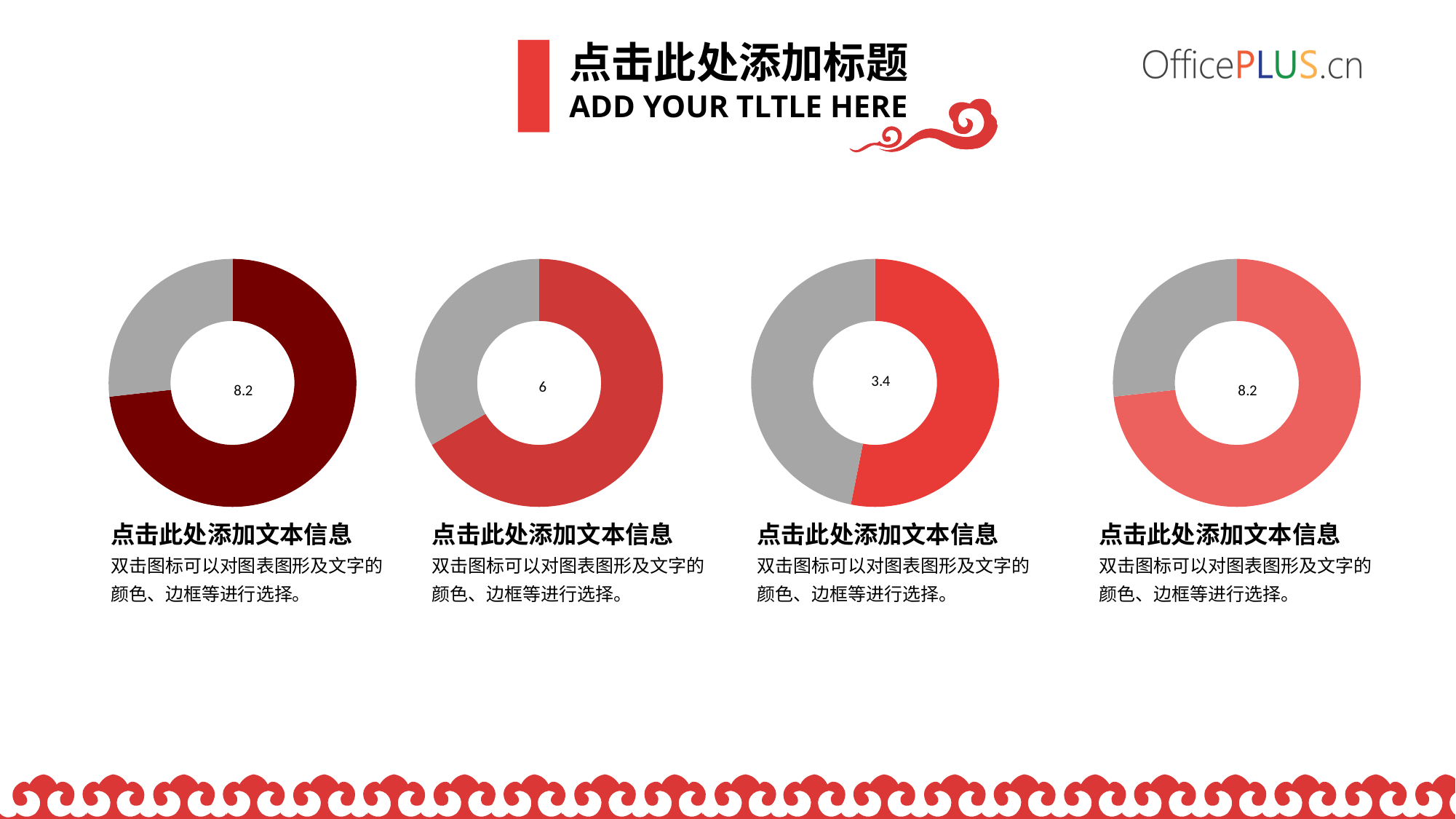
How many doughnut charts are shown on the slide? 4 What value is printed in the centre of the rightmost doughnut chart? 8.2 What kind of chart is the leftmost chart on the slide? Doughnut chart What is the difference between the centre value of the second chart (6) and the third chart (3.4)? 2.6 How many slices does each doughnut chart contain? 2 In the leftmost doughnut chart, which slice is larger, the dark red slice or the grey slice? The dark red slice What value is printed in the centre of the third doughnut chart from the left? 3.4 What value is printed in the centre of the second doughnut chart from the left? 6 What colour is the smaller slice in each of the four doughnut charts? Grey Which centre value is larger, the second chart's or the third chart's? The second chart's (6) Which doughnut chart has the lowest centre value? The third from the left (3.4) What value is printed in the centre of the leftmost doughnut chart? 8.2